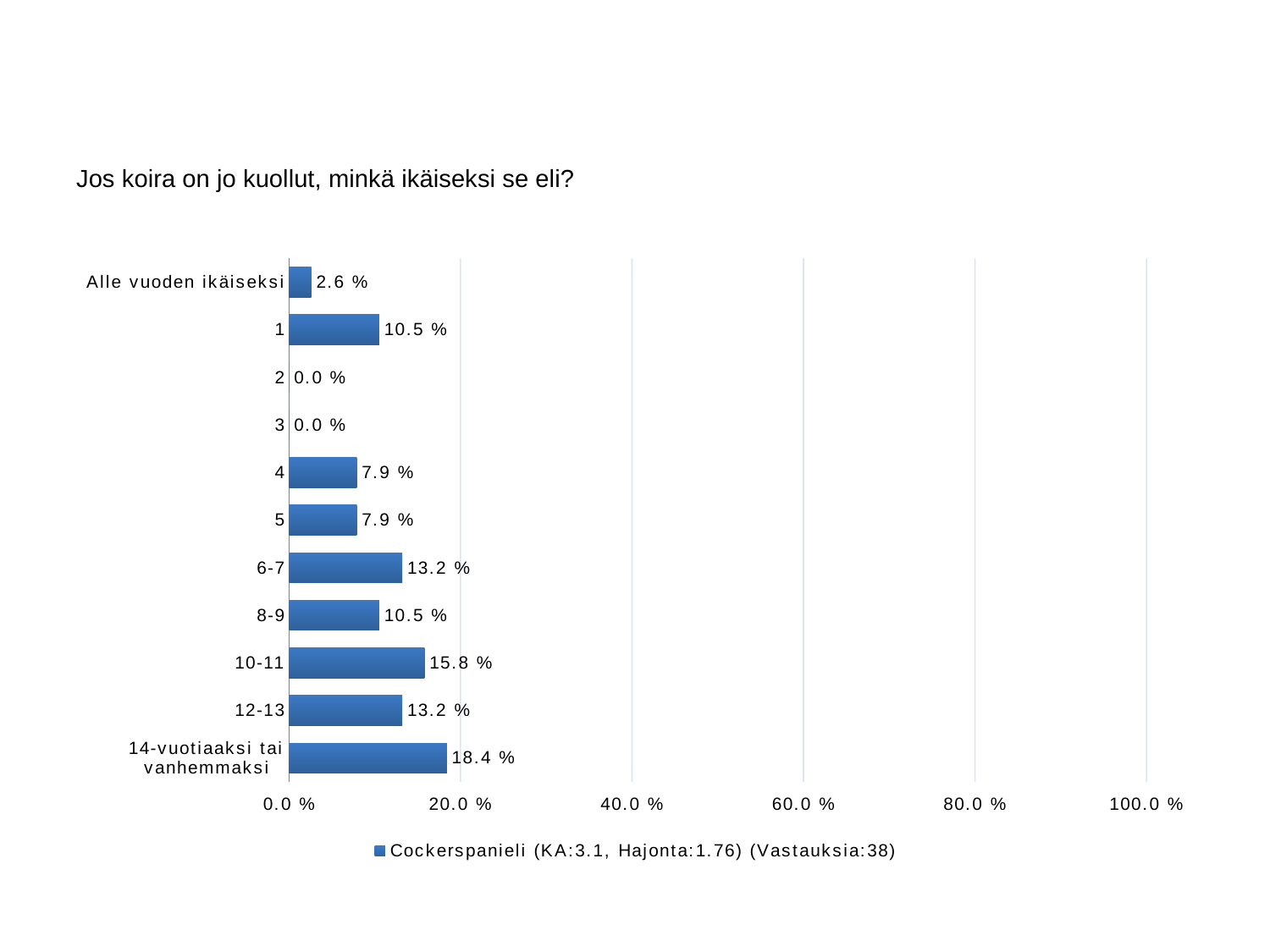
How many categories have a value of 0.0 %? 2 What is the value for the category "6-7"? 13.2 % Which category has the highest value? 14-vuotiaaksi tai vanhemmaksi Which is larger, the value for "1" or the value for "4"? 1 What is the difference between the values for "10-11" and "8-9"? 5.3 % What is the value for the category "Alle vuoden ikäiseksi"? 2.6 % What is the title of the chart? Jos koira on jo kuollut, minkä ikäiseksi se eli? What kind of chart is shown on the slide? bar chart Is the value for "14-vuotiaaksi tai vanhemmaksi" greater or less than 20.0 %? less How many categories are shown on the chart? 11 What is the value for the category "14-vuotiaaksi tai vanhemmaksi"? 18.4 % How many series does the legend list? 1